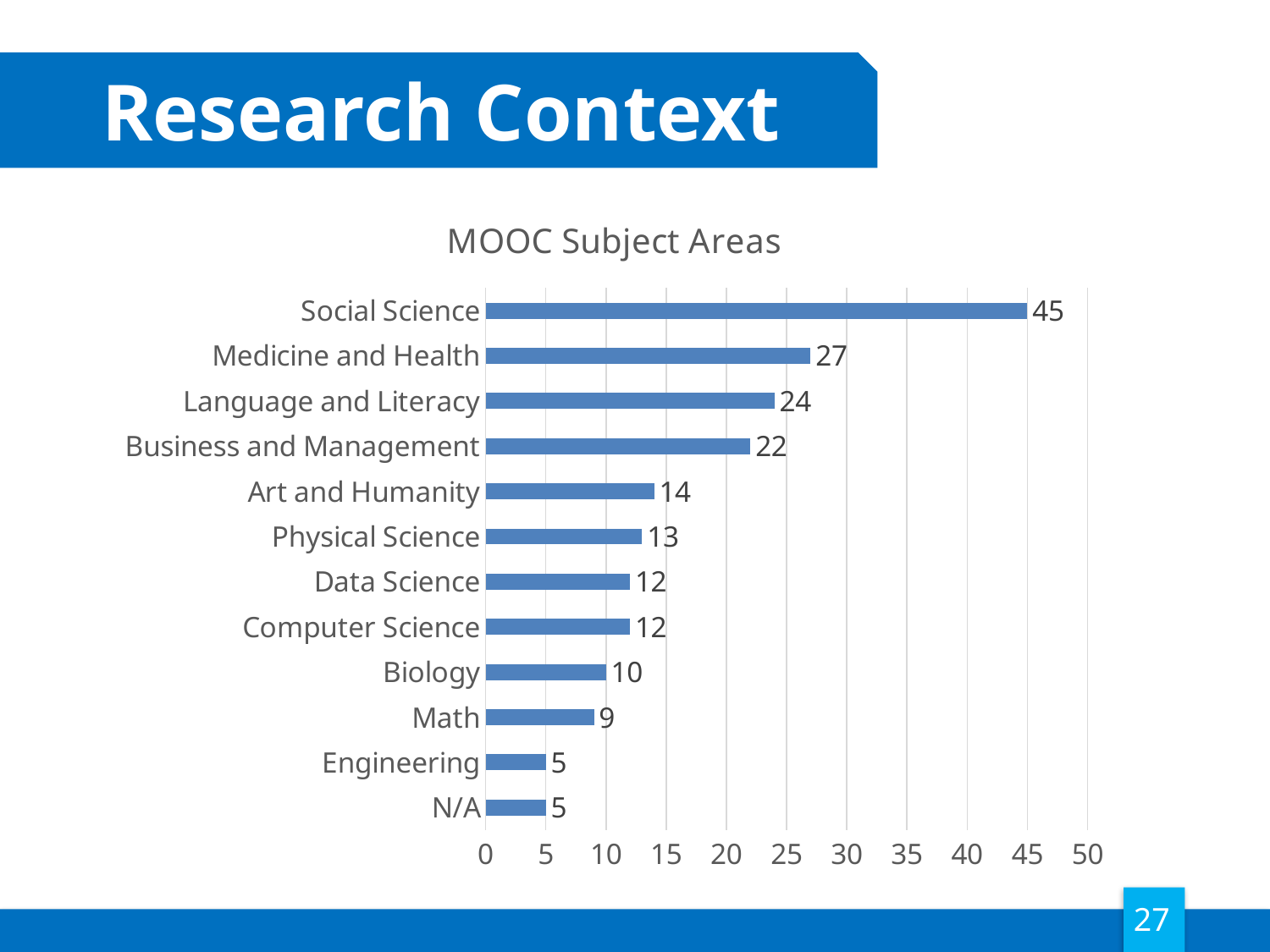
Is the value for Medicine and Health greater or less than 25? greater How many subject areas are shown in the chart? 12 What is the value for Language and Literacy? 24 What is the value for Biology? 10 What is the title of the chart? MOOC Subject Areas What kind of chart is shown on the slide? Bar chart Which is larger, the value for Art and Humanity or the value for Physical Science? Art and Humanity What is the difference between the values for Social Science and Math? 36 What is the value for Social Science in the MOOC Subject Areas chart? 45 What is the difference between the values for Medicine and Health and Business and Management? 5 Which subject area has the highest value? Social Science Which subject area has the lowest value, other than N/A? Engineering